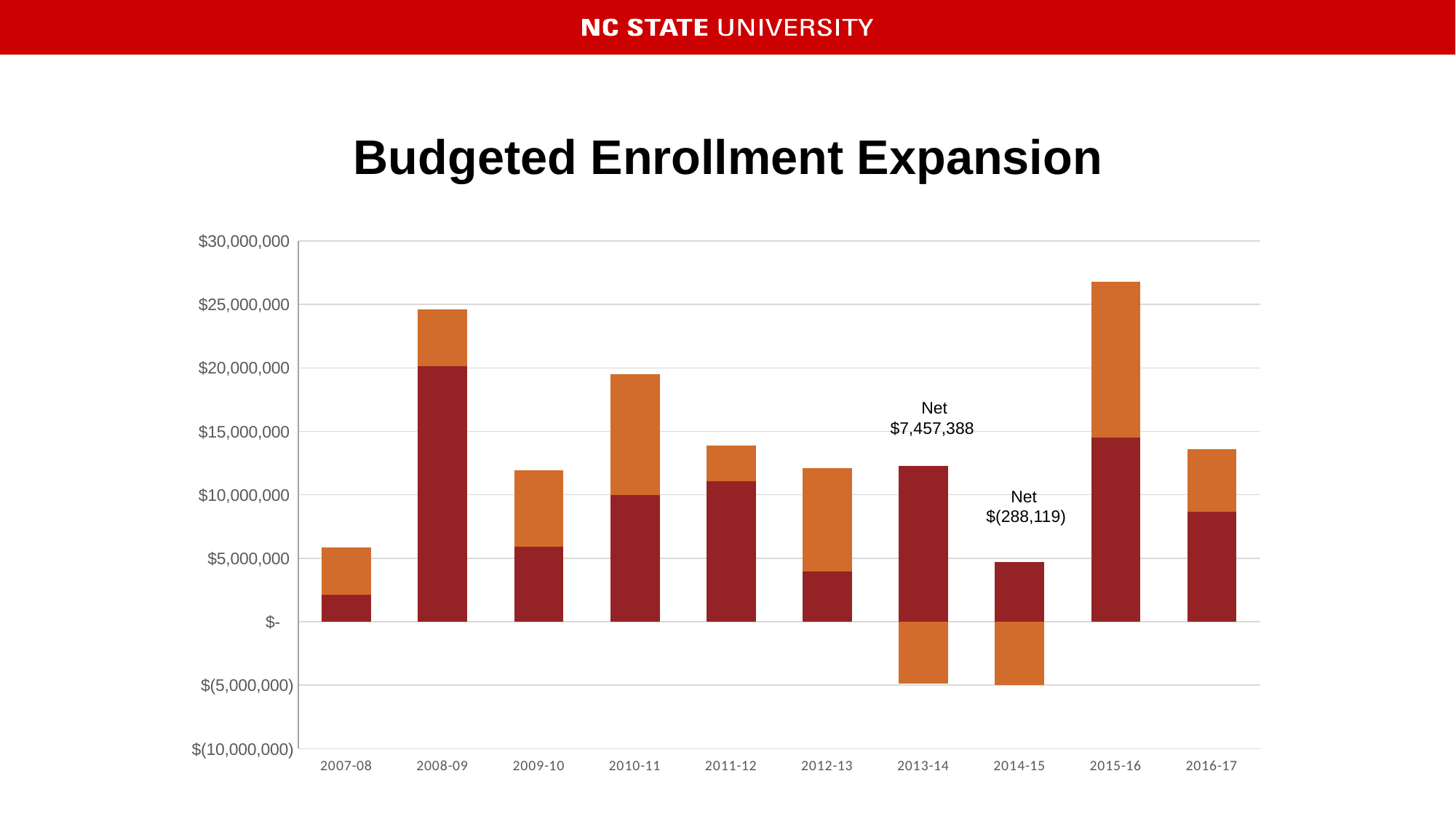
How many fiscal years are shown on the x axis of the chart? 10 Is the top of the stacked bar for 2015-16 greater or less than $25,000,000? greater Which years have an orange segment extending below zero? 2013-14 and 2014-15 Is the dark red segment for 2012-13 greater or less than $5,000,000? less Is the dark red segment for 2011-12 greater or less than $10,000,000? greater Which year has the tallest stacked bar? 2015-16 What net value is annotated for 2014-15? $(288,119) Which stacked bar is taller, 2008-09 or 2009-10? 2008-09 What net value is annotated for 2013-14? $7,457,388 What kind of chart is shown on the slide? Stacked bar chart What is the title of the chart? Budgeted Enrollment Expansion